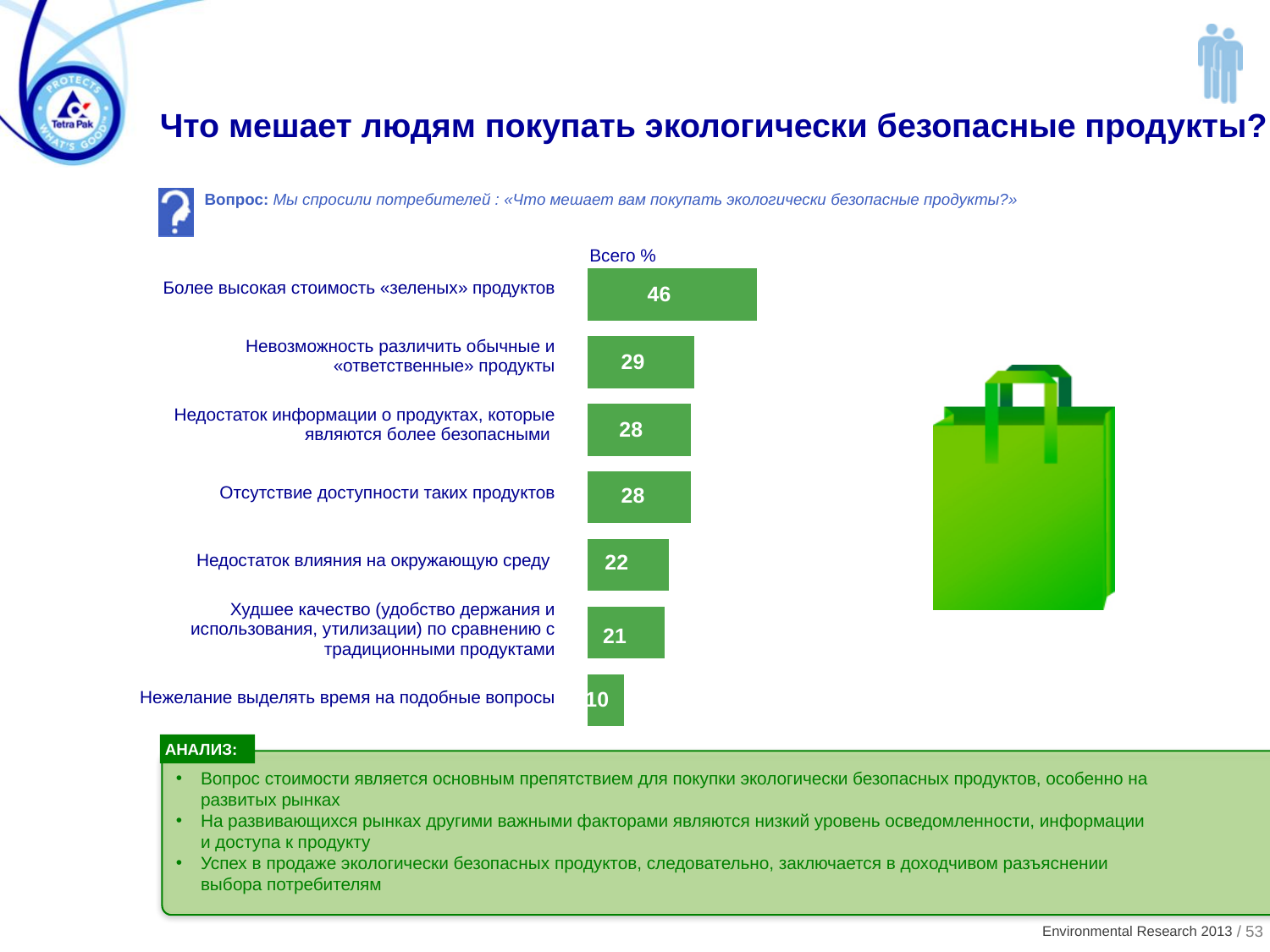
What value is shown for «Недостаток влияния на окружающую среду»? 22 What value is shown for «Более высокая стоимость «зеленых» продуктов»? 46 What is the label shown above the bars in the chart? Всего % Which category has the lowest value? Нежелание выделять время на подобные вопросы What value is shown for «Нежелание выделять время на подобные вопросы»? 10 Which is larger: the value for «Отсутствие доступности таких продуктов» or the value for «Худшее качество (удобство держания и использования, утилизации) по сравнению с традиционными продуктами»? Отсутствие доступности таких продуктов What kind of chart is shown on the slide? Bar chart How many categories are shown in the bar chart? 7 Which category has the highest value? Более высокая стоимость «зеленых» продуктов What is the difference between the values for «Недостаток влияния на окружающую среду» and «Нежелание выделять время на подобные вопросы»? 12 What is the difference between the values for «Более высокая стоимость «зеленых» продуктов» and «Невозможность различить обычные и «ответственные» продукты»? 17 What value is shown for «Невозможность различить обычные и «ответственные» продукты»? 29